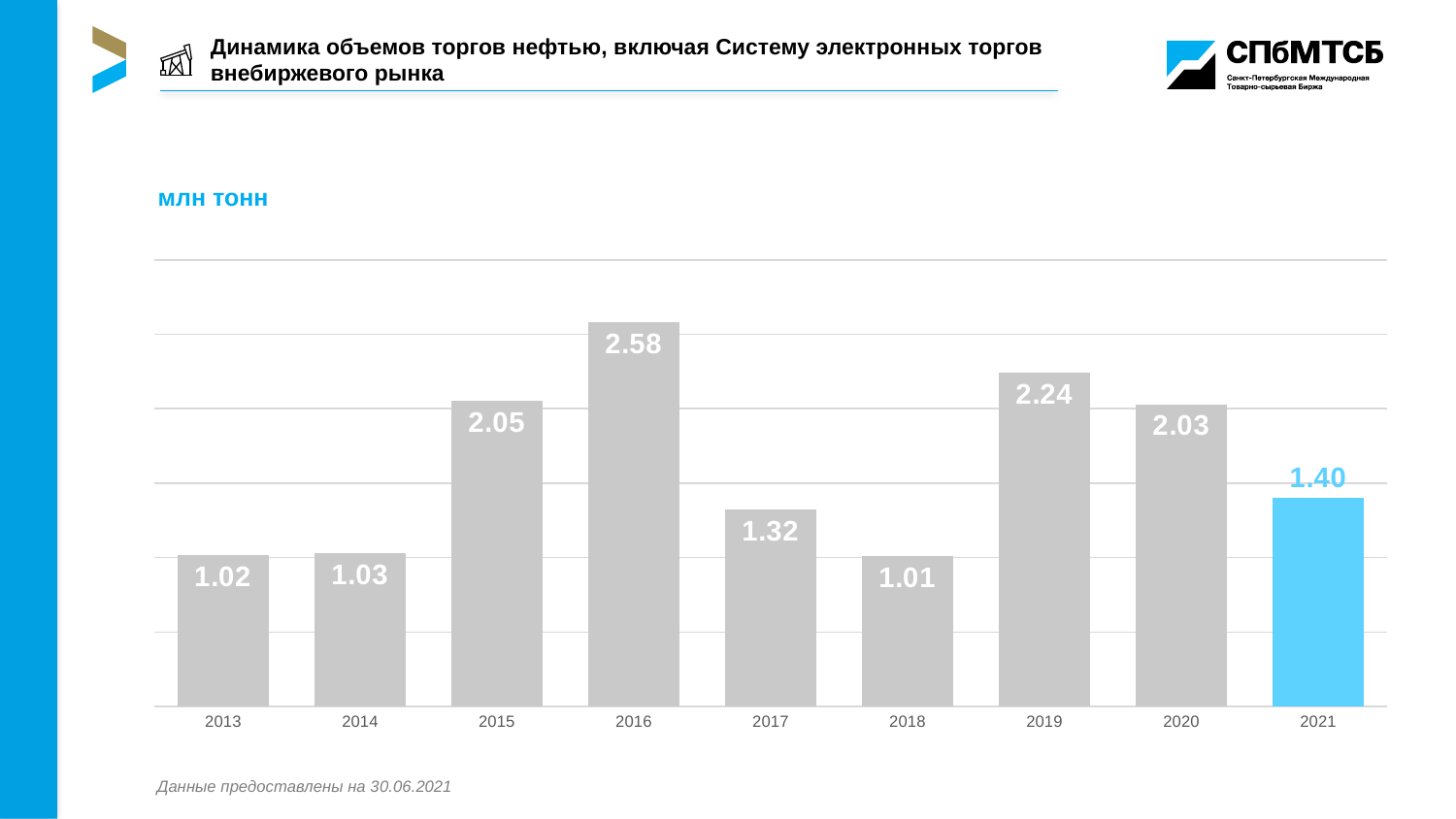
What is the difference between the values for 2019 and 2020? 0.21 Do the values rise or fall from 2017 to 2018? fall Which year has the highest value? 2016 How many years are shown on the chart? 9 What is the value for 2016? 2.58 Which is larger, the value for 2015 or the value for 2020? 2015 What unit is stated above the chart? млн тонн What is the value for 2021? 1.40 What is the difference between the values for 2016 and 2017? 1.26 Which year has the lowest value? 2018 What is the value for 2018? 1.01 What kind of chart is shown on the slide? bar chart